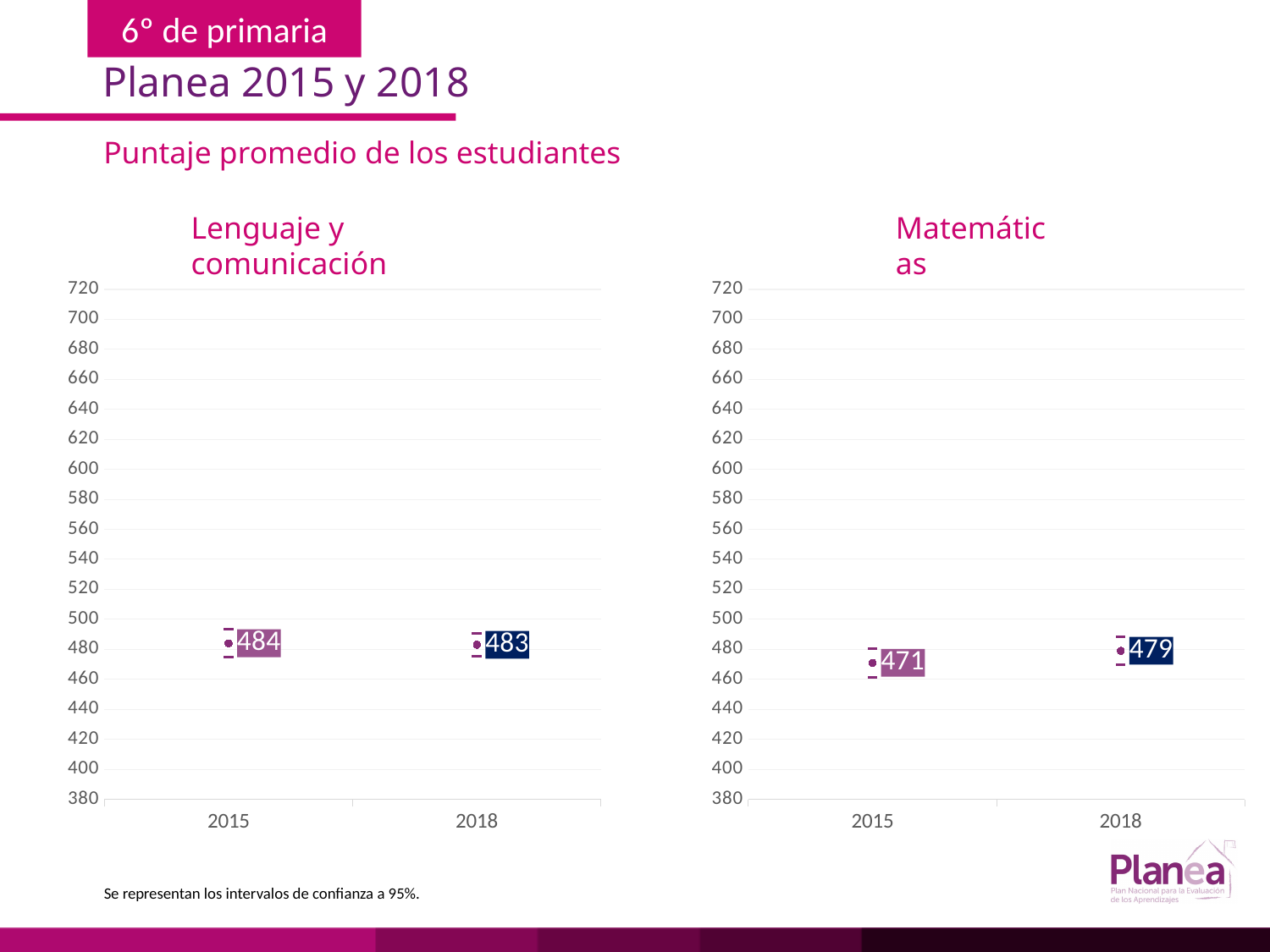
In the Matemáticas chart, what is the value for 2015? 471 In the Matemáticas chart, what is the difference between the 2018 and 2015 values? 8 In the Matemáticas chart, which year has the higher value? 2018 In the Matemáticas chart, what is the value for 2018? 479 In the Lenguaje y comunicación chart, what is the value for 2015? 484 In the Matemáticas chart, is the value for 2015 greater or less than 480? less In the Matemáticas chart, which year has the lowest value? 2015 In the Lenguaje y comunicación chart, what is the difference between the 2015 and 2018 values? 1 In the Matemáticas chart, do the values rise or fall from 2015 to 2018? rise How many years are plotted in the Lenguaje y comunicación chart? 2 What is the title of the chart on the right side of the slide? Matemáticas In the Lenguaje y comunicación chart, what is the value for 2018? 483